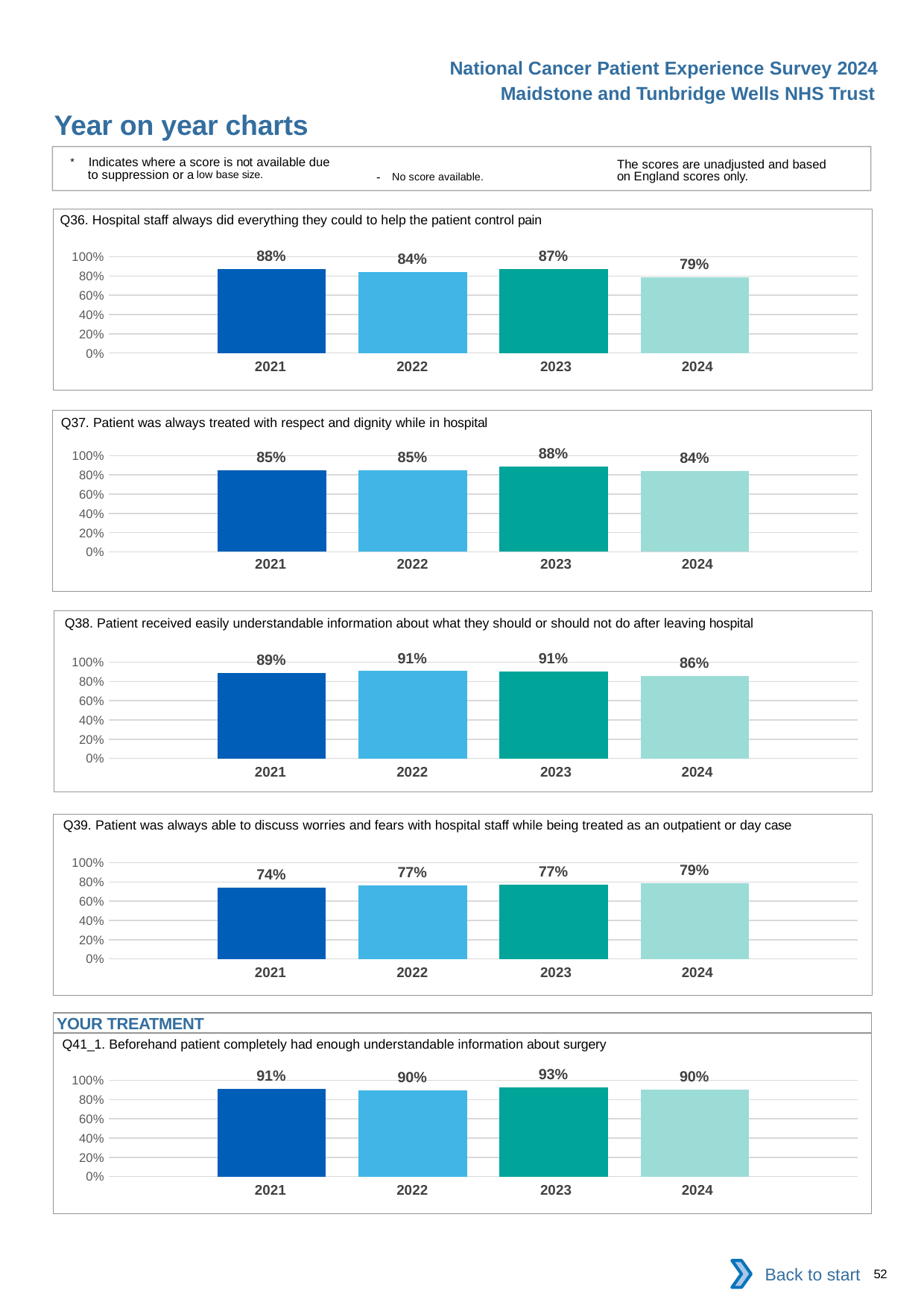
In the Q38 chart, what is the value for 2021? 89% In the Q36 chart (hospital staff always did everything they could to help the patient control pain), what is the value for 2024? 79% In the Q36 chart, which year has the highest value? 2021 In the Q39 chart, do the values generally rise or fall from 2021 to 2024? rise In the Q41_1 chart (enough understandable information about surgery), what is the value for 2023? 93% What type of chart is used for Q37? bar chart In the Q37 chart (patient was always treated with respect and dignity while in hospital), what is the value for 2023? 88% In the Q38 chart (easily understandable information after leaving hospital), which year has the lowest value? 2024 In the Q37 chart, what is the difference between the 2023 and 2024 values? 4 percentage points In the Q41_1 chart, what is the difference between the 2023 and 2022 values? 3 percentage points In the Q39 chart (discuss worries and fears as an outpatient or day case), which is larger: the value for 2021 or the value for 2024? 2024 How many years (categories) are shown in the Q36 chart? 4